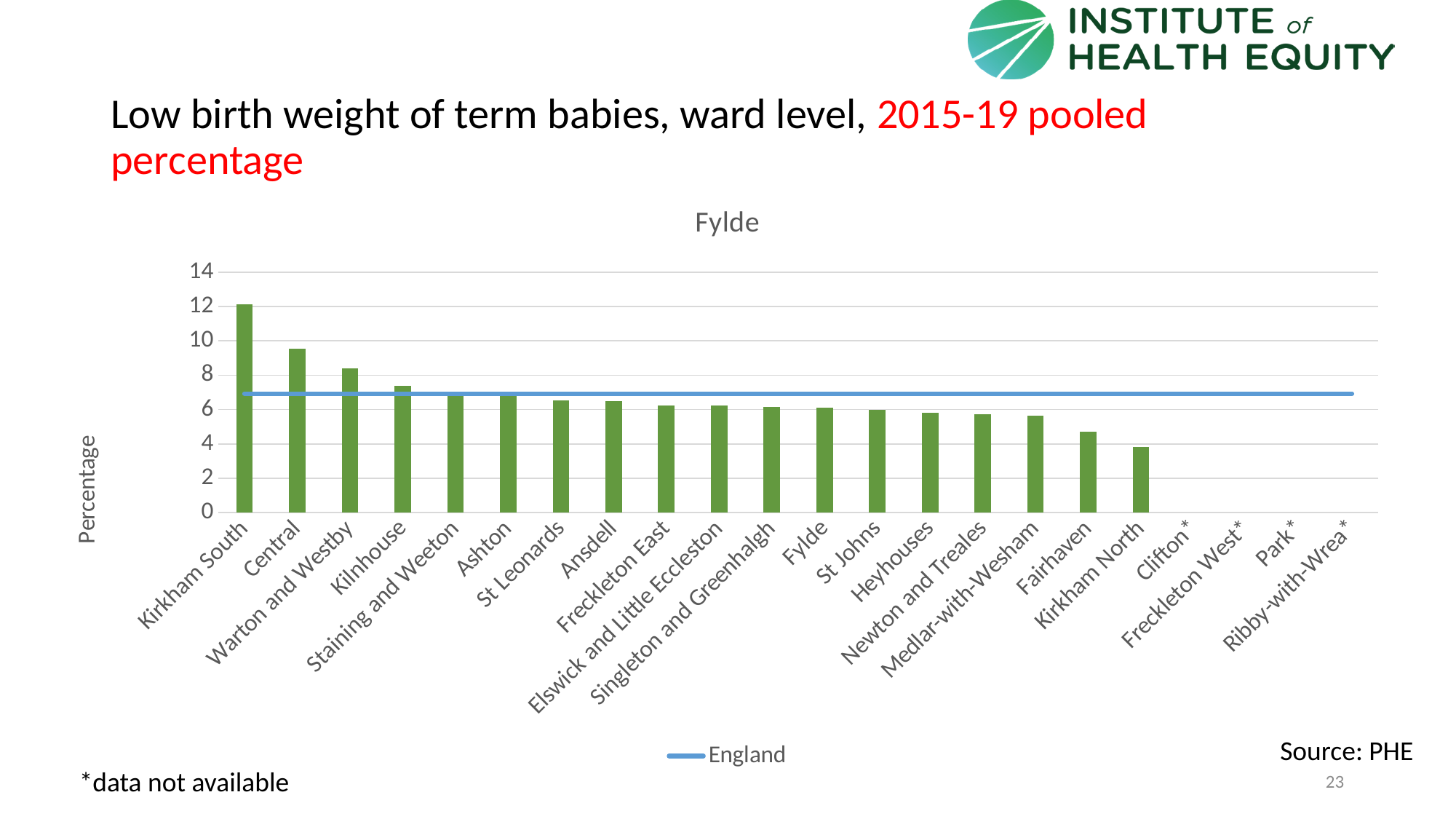
What does the blue horizontal line in the chart represent, according to the legend? England Among the wards with a plotted bar, which has the lowest low birth weight percentage? Kirkham North Is the value for Central greater or less than 10? less Is the value for Fairhaven greater or less than 6? less What kind of chart is shown on the slide? bar chart Do the bar values rise or fall moving from left to right along the x axis? fall How many ward categories are listed along the x axis of the chart? 22 Which is larger, the value for Central or the value for Kilnhouse? Central Which ward has the highest low birth weight percentage in the Fylde chart? Kirkham South Is the value for Warton and Westby greater or less than 8? greater